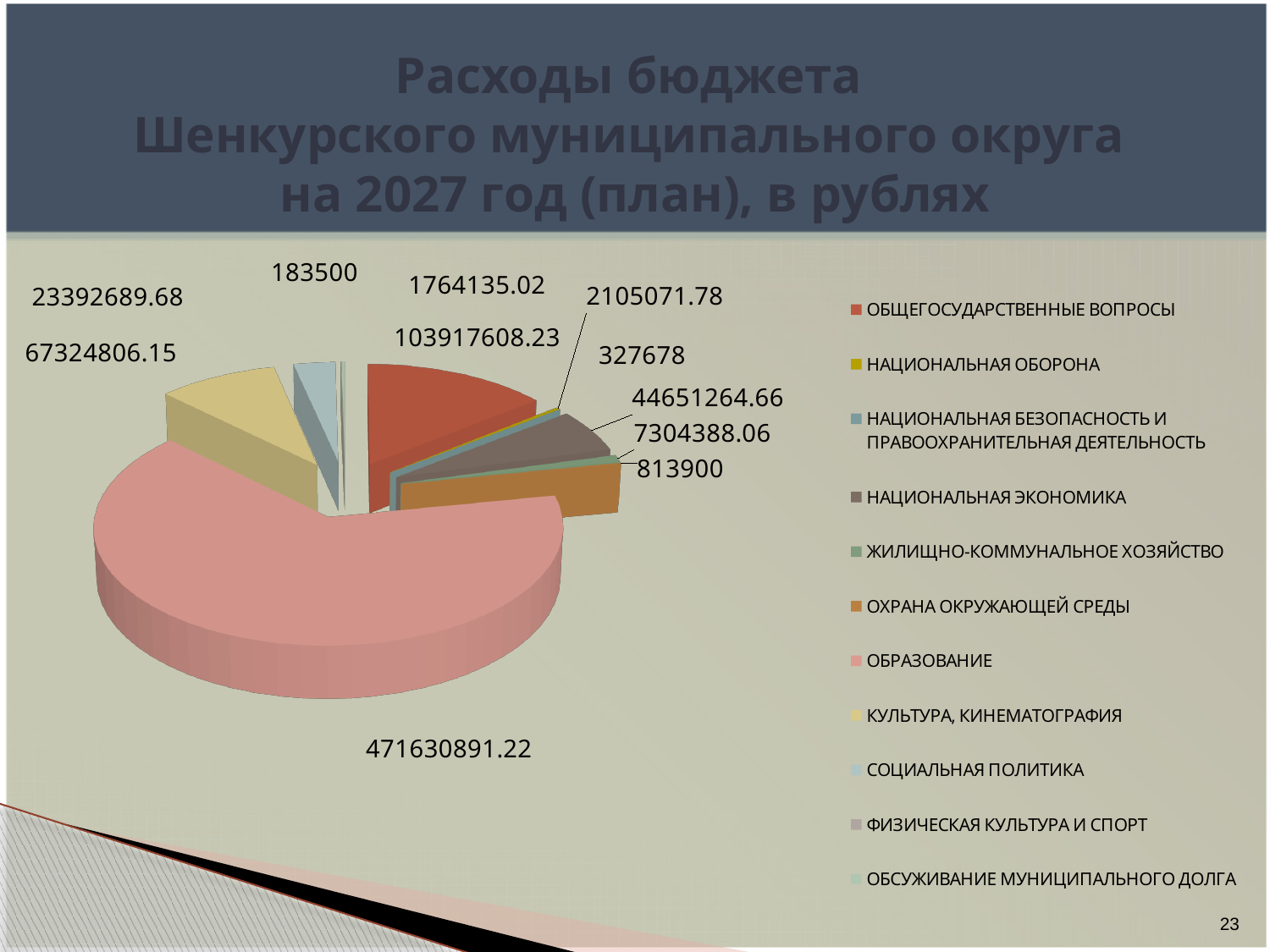
How many categories does the legend of the pie chart list? 11 Which category has the largest share of the pie? ОБРАЗОВАНИЕ What is the value for КУЛЬТУРА, КИНЕМАТОГРАФИЯ? 67324806.15 What is the difference between the values for ОБРАЗОВАНИЕ and ОБЩЕГОСУДАРСТВЕННЫЕ ВОПРОСЫ? 367713282.99 Which is larger: the value for ОБРАЗОВАНИЕ or the value for ОБЩЕГОСУДАРСТВЕННЫЕ ВОПРОСЫ? ОБРАЗОВАНИЕ What type of chart is shown on the slide? Pie chart What is the value for ОБРАЗОВАНИЕ? 471630891.22 What is the difference between the values for КУЛЬТУРА, КИНЕМАТОГРАФИЯ and СОЦИАЛЬНАЯ ПОЛИТИКА? 43932116.47 What is the value for ОБЩЕГОСУДАРСТВЕННЫЕ ВОПРОСЫ? 103917608.23 What is the value for СОЦИАЛЬНАЯ ПОЛИТИКА? 23392689.68 What year does the chart title say the planned budget expenditures are for? 2027 What is the value for НАЦИОНАЛЬНАЯ ЭКОНОМИКА? 44651264.66